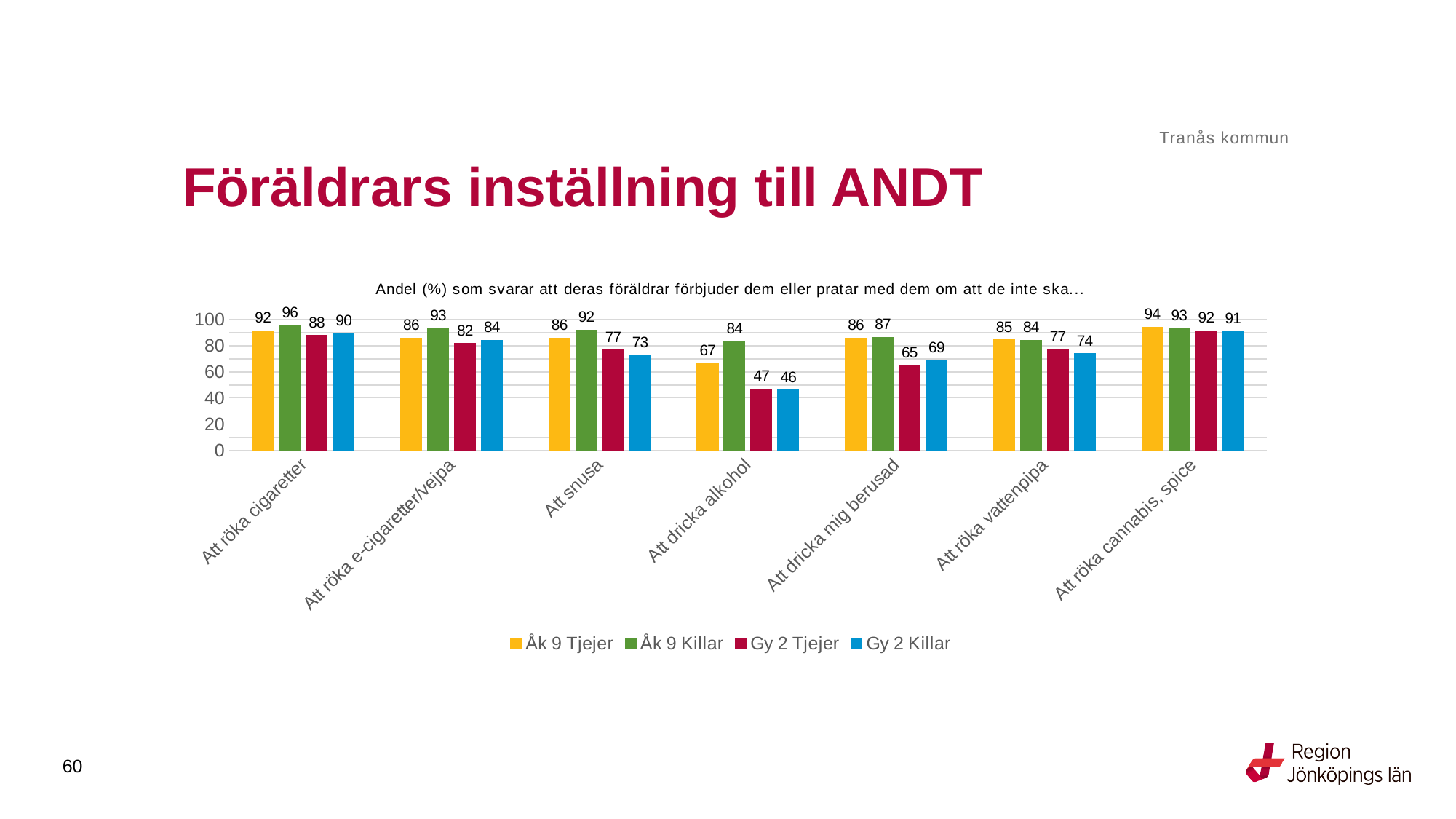
What is the value for Gy 2 Killar for 'Att dricka mig berusad'? 69 What is the value for Åk 9 Killar for 'Att röka cigaretter'? 96 Which category has the highest value for Åk 9 Tjejer? Att röka cannabis, spice What is the difference between Åk 9 Killar and Gy 2 Tjejer for 'Att dricka alkohol'? 37 What is the value for Gy 2 Tjejer for 'Att dricka alkohol'? 47 Which is larger for 'Att snusa': Åk 9 Tjejer or Gy 2 Killar? Åk 9 Tjejer How many series does the legend list? 4 What kind of chart is shown on the slide? Bar chart How many categories are shown on the x axis? 7 Which series is shown in blue in the legend? Gy 2 Killar What is the difference between Åk 9 Tjejer and Gy 2 Tjejer for 'Att röka vattenpipa'? 8 Which category has the lowest value for Gy 2 Killar? Att dricka alkohol